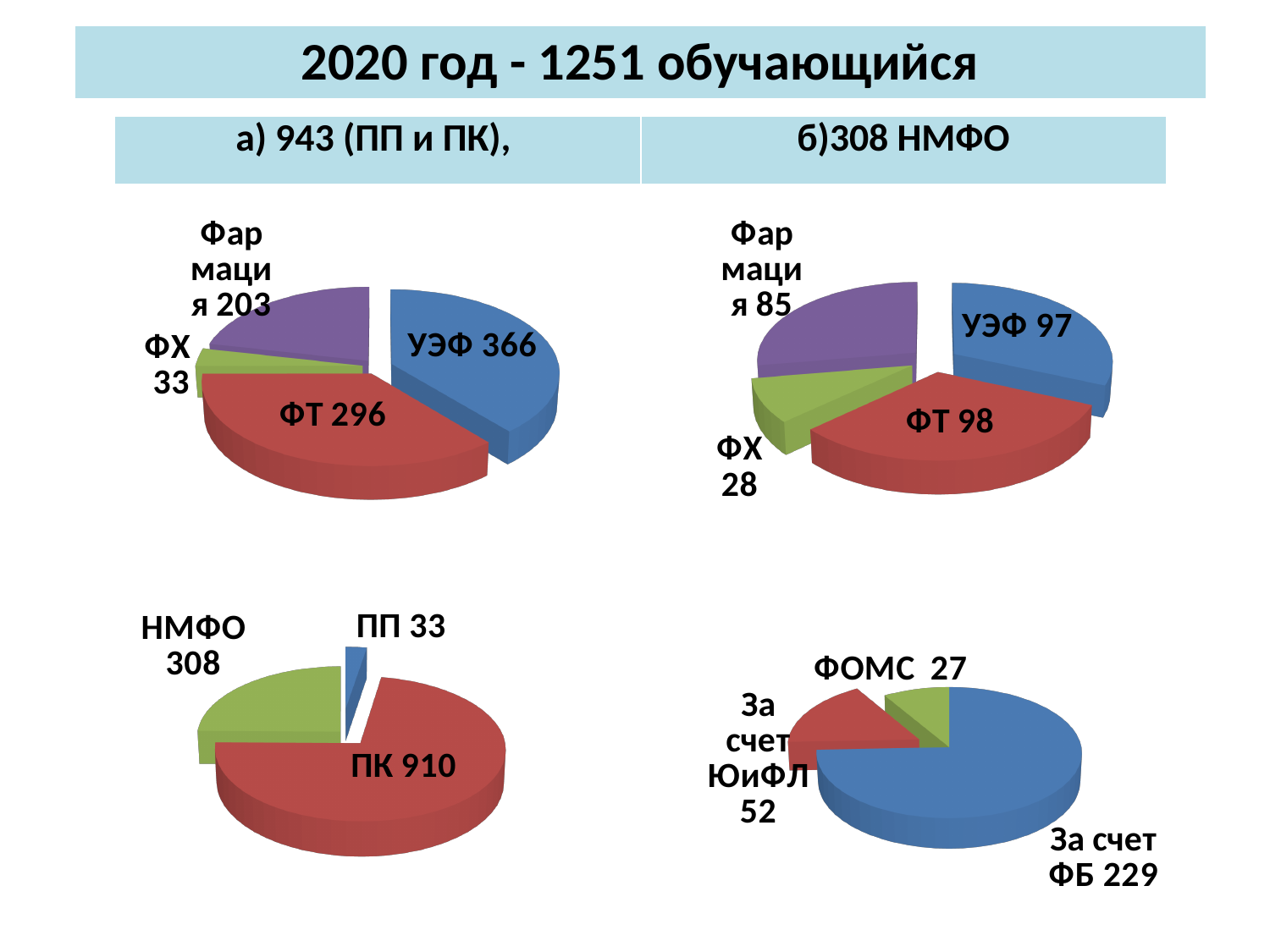
In the bottom-right pie chart, what is the value for За счет ЮиФЛ? 52 In the bottom-left pie chart, what is the value for ПК? 910 In the top-right pie chart, what is the value for Фармация? 85 In the bottom-left pie chart, which category has the largest value? ПК In the top-right pie chart, which category has the smallest value? ФХ In the top-left pie chart, which category has the smallest value? ФХ In the bottom-right pie chart, which is larger, За счет ФБ or ФОМС? За счет ФБ In the top-left pie chart, what is the difference between the values for УЭФ and ФТ? 70 What kind of chart is the bottom-right chart? Pie chart In the top-right pie chart, how many categories are shown? 4 In the top-left pie chart, what is the value for УЭФ? 366 In the bottom-left pie chart, what is the difference between the values for НМФО and ПП? 275